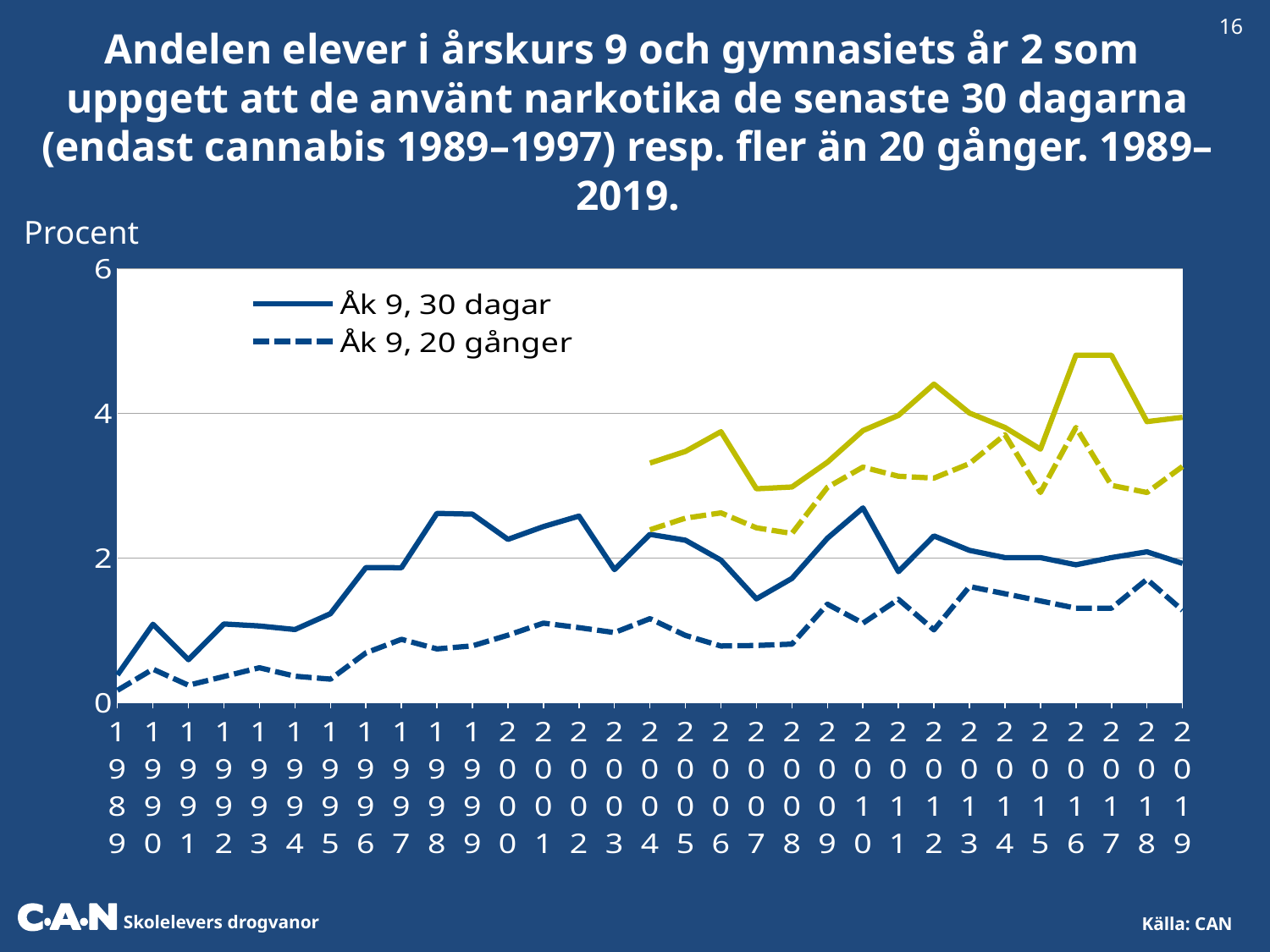
In 2010, which is higher: Åk 9, 30 dagar or Åk 9, 20 gånger? Åk 9, 30 dagar Is the value for Åk 9, 20 gånger in 2019 greater or less than 2? less Does the Åk 9, 30 dagar line rise or fall from 1989 to 1998? rise Is the value for Åk 9, 30 dagar in 2007 greater or less than 2? less Is the value for Åk 9, 30 dagar in 1998 greater or less than 2? greater What label is shown on the y axis? Procent How many years are shown along the x axis? 31 What kind of chart is shown on the slide? line chart How many series does the legend list? 2